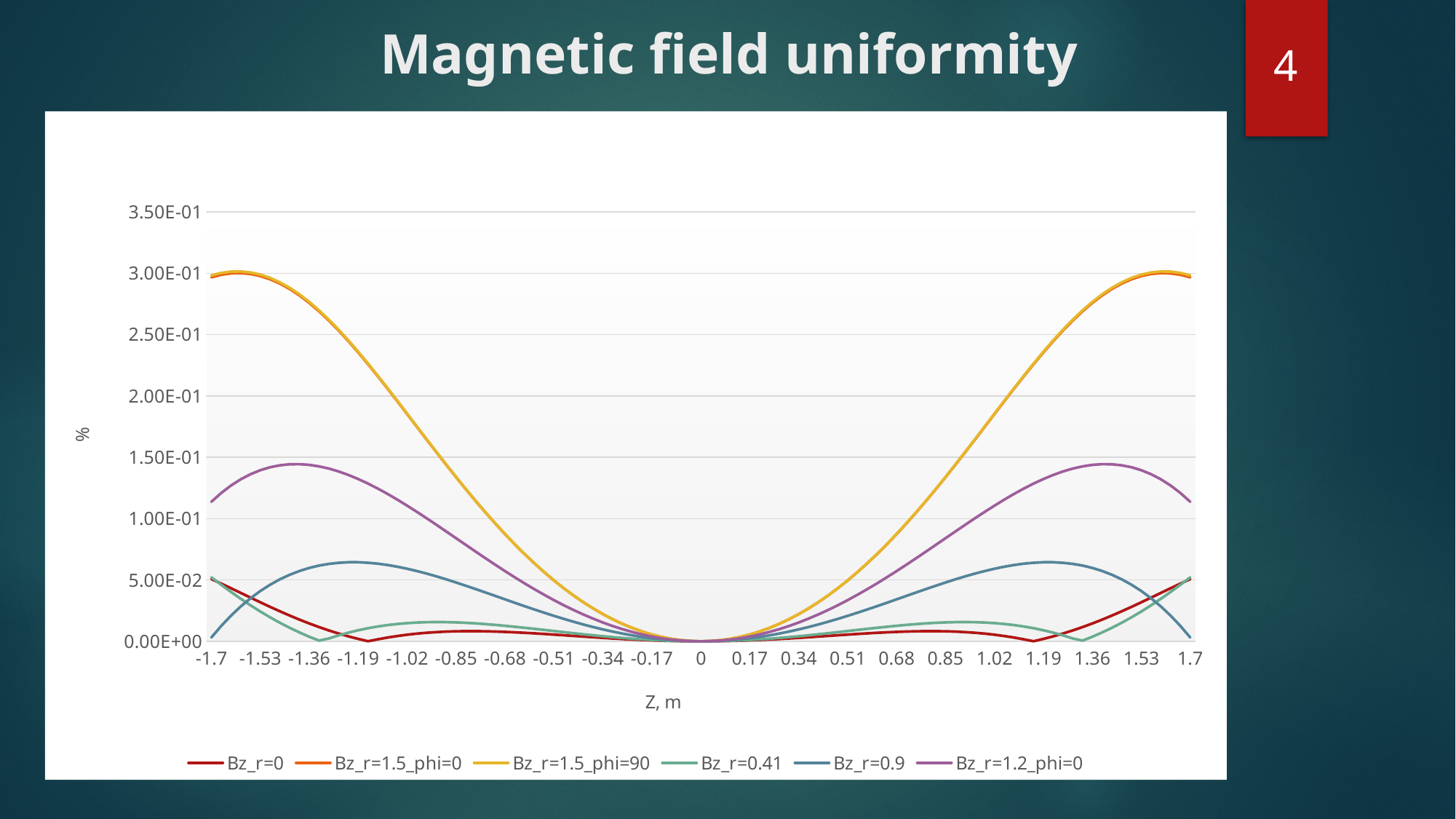
Is the value for Bz_r=1.2_phi=0 at Z = -1.53 greater or less than 1.00E-01? greater Is the value for Bz_r=1.5_phi=0 at Z = -1.7 greater or less than 2.50E-01? greater What kind of chart is shown on the slide? line chart How many series does the legend list? 6 What is the label of the x axis? Z, m Is the value for Bz_r=0.9 at Z = -1.19 greater or less than 5.00E-02? greater How many tick labels are shown on the x axis? 21 Does the Bz_r=1.5_phi=90 series rise or fall as Z goes from 0 to 1.53? rise At Z = -1.7, which is larger: Bz_r=1.2_phi=0 or Bz_r=0.9? Bz_r=1.2_phi=0 What is the title of the chart? Magnetic field uniformity